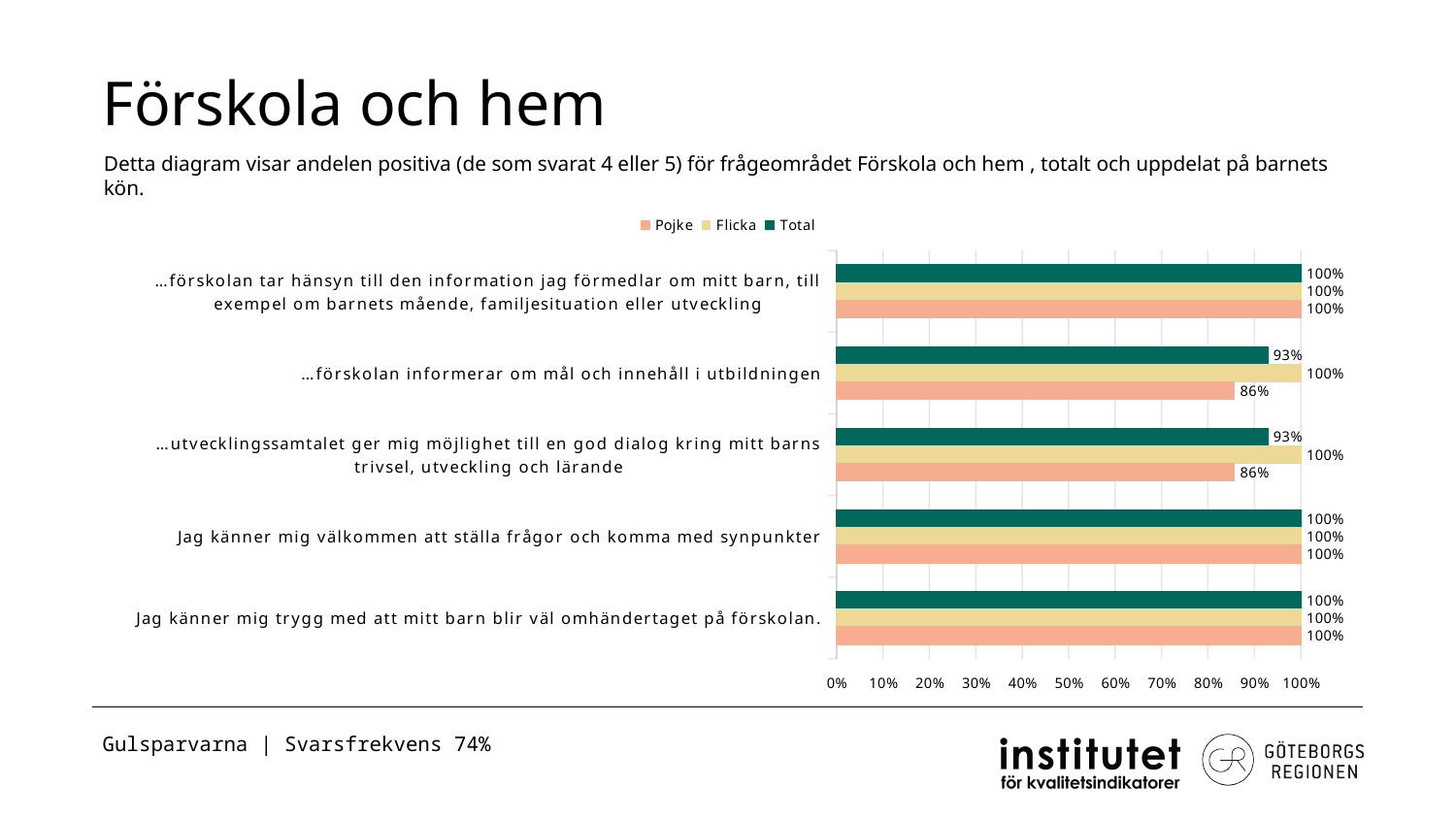
How many series does the legend list? 3 What is the Total value for "Jag känner mig trygg med att mitt barn blir väl omhändertaget på förskolan."? 100% Which is larger for "…utvecklingssamtalet ger mig möjlighet till en god dialog kring mitt barns trivsel, utveckling och lärande": the Flicka value or the Pojke value? Flicka What is the difference between the Flicka and Pojke values for "…förskolan informerar om mål och innehåll i utbildningen"? 14% Which series has the lowest value for "…förskolan informerar om mål och innehåll i utbildningen"? Pojke Is the Pojke value for "…utvecklingssamtalet ger mig möjlighet till en god dialog kring mitt barns trivsel, utveckling och lärande" greater or less than 90%? less How many categories (statements) are shown on the chart? 5 What is the Total value for "…utvecklingssamtalet ger mig möjlighet till en god dialog kring mitt barns trivsel, utveckling och lärande"? 93% Which legend entry is shown in dark green? Total What is the Pojke value for "…förskolan informerar om mål och innehåll i utbildningen"? 86% What kind of chart is shown on the slide? bar chart What is the Flicka value for "…förskolan informerar om mål och innehåll i utbildningen"? 100%